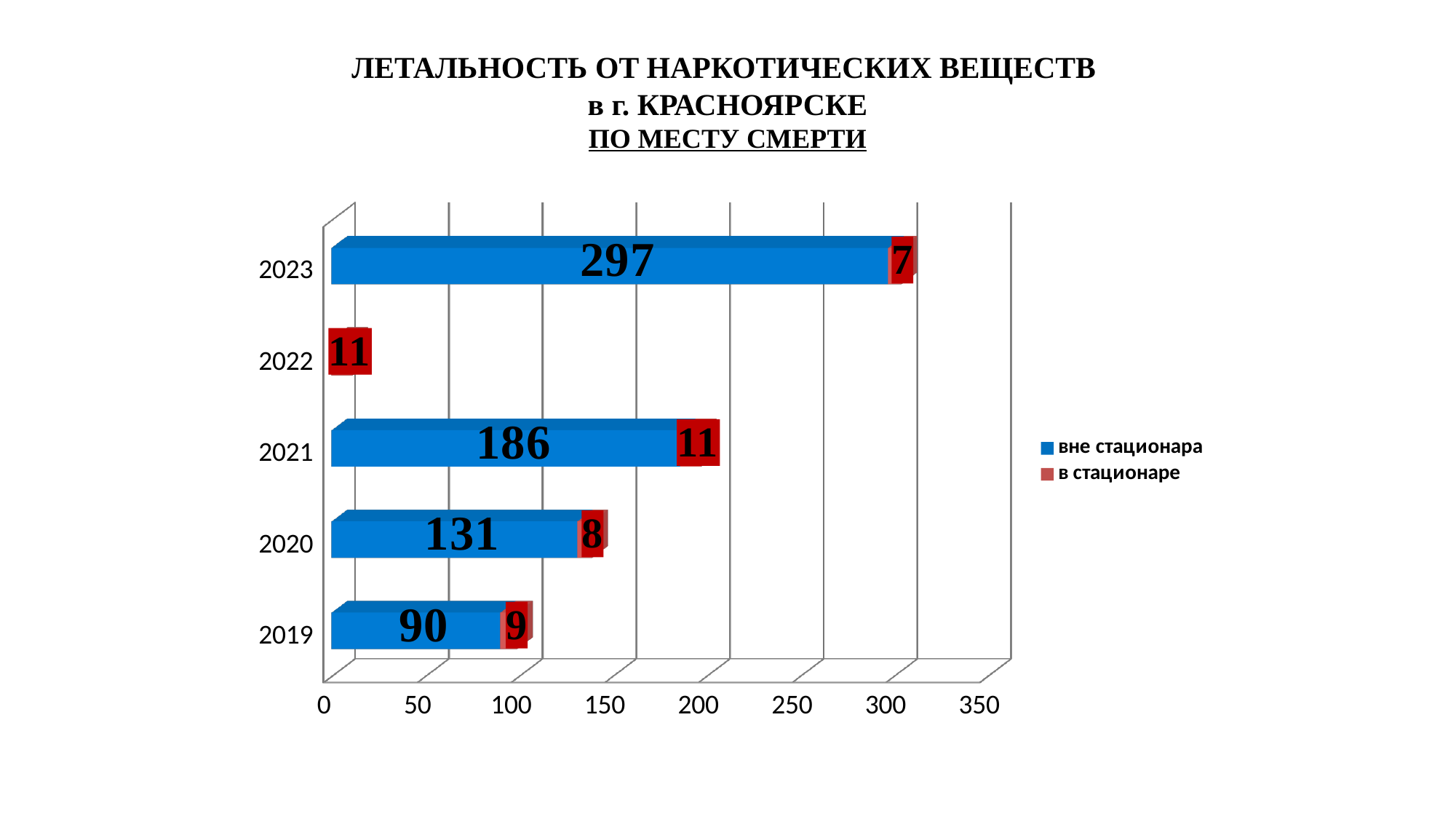
What is the value for "вне стационара" in 2023? 297 Which year has the lowest value for "в стационаре"? 2023 Which year has the highest value for "вне стационара"? 2023 How many series does the legend list? 2 What is the value for "в стационаре" in 2021? 11 What kind of chart is shown on the slide? Stacked bar chart What is the value for "вне стационара" in 2019? 90 Which is larger: the "вне стационара" value for 2020 or for 2019? 2020 What is the total of the stacked bar for 2021? 197 What is the value for "в стационаре" in 2020? 8 What is the difference between the "вне стационара" values for 2023 and 2021? 111 Which colour represents "в стационаре" in the chart? Red